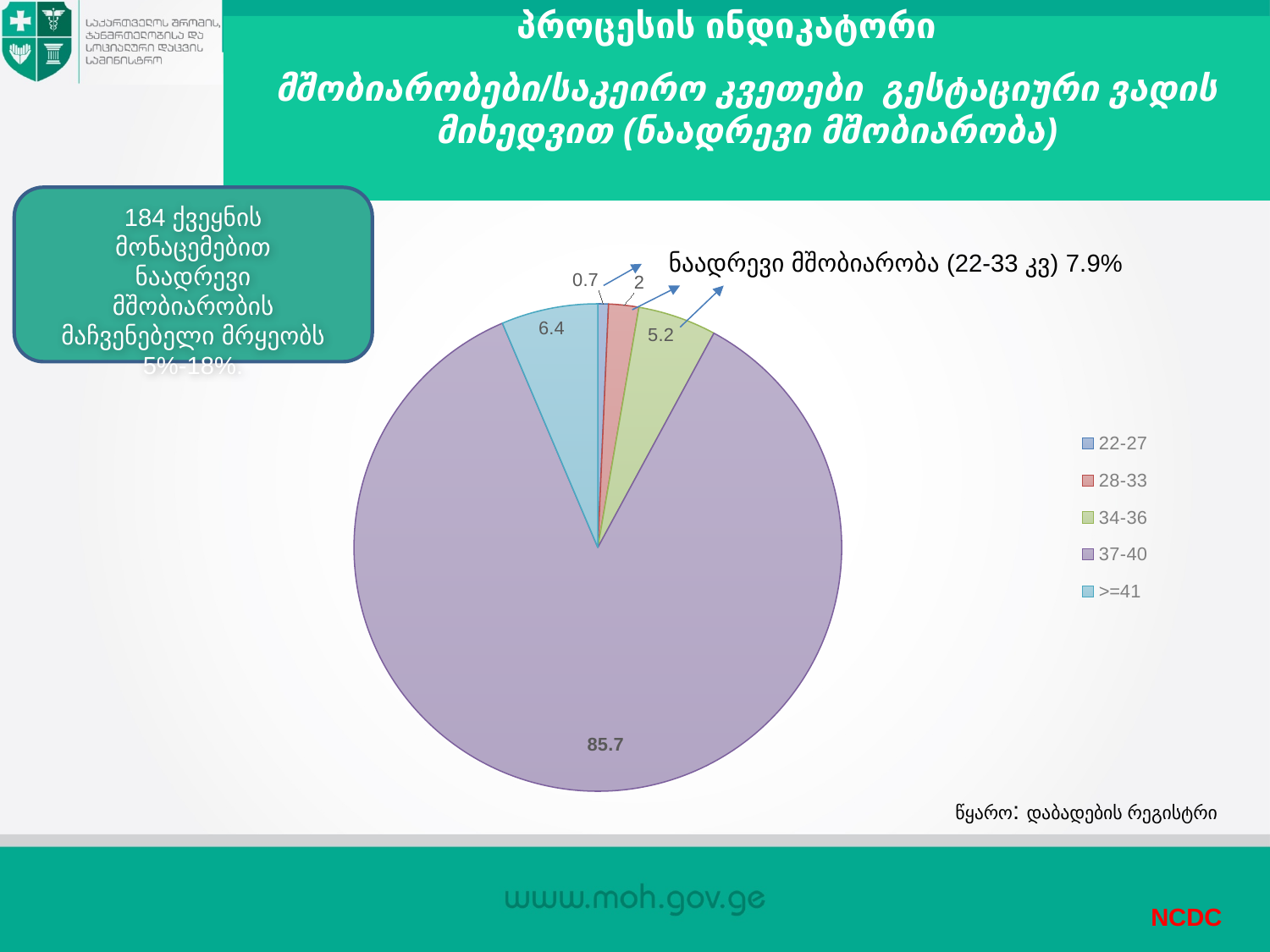
Which category has the largest slice of the pie? 37-40 What colour is the 37-40 slice? purple Which is larger, the value for >=41 or the value for 34-36? >=41 What type of chart is shown on the slide? pie chart How many categories does the legend list? 5 What is the value for the 34-36 slice? 5.2 What is the difference between the values for 37-40 and >=41? 79.3 Which category has the smallest slice of the pie? 22-27 What is the value for the 22-27 slice? 0.7 What is the value for the 37-40 slice? 85.7 What is the value for the 28-33 slice? 2 What is the value for the >=41 slice? 6.4